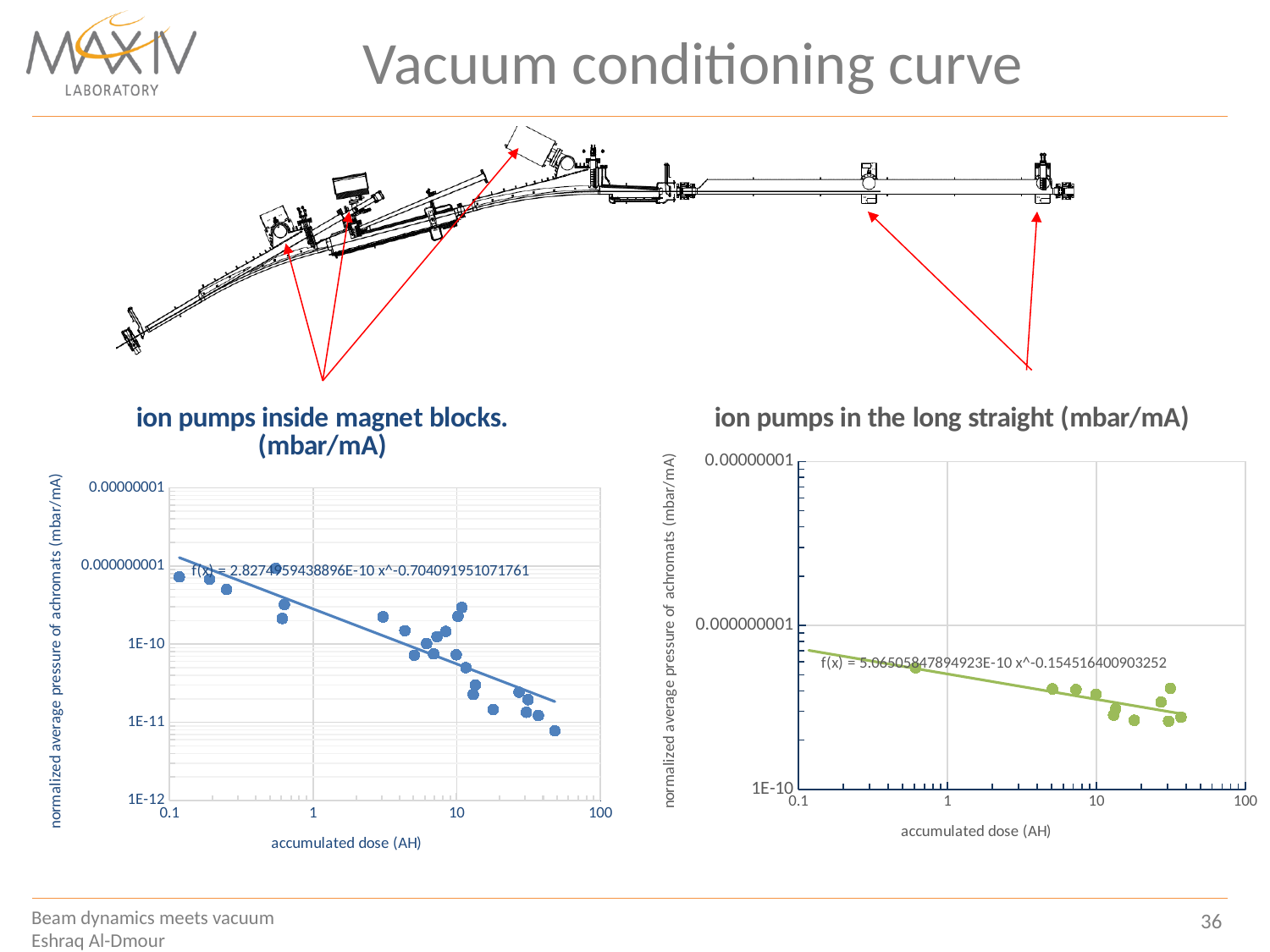
What kind of chart is the 'ion pumps in the long straight' chart? scatter chart What is the trendline equation shown on the 'ion pumps in the long straight' chart? f(x) = 5.06505847894923E-10 x^-0.154516400903252 In the 'ion pumps in the long straight' chart, do the plotted values rise or fall as accumulated dose increases? fall What is the lowest value shown on the y-axis of the 'ion pumps inside magnet blocks' chart? 1E-12 In the 'ion pumps inside magnet blocks' chart, is the value at an accumulated dose of about 0.1 AH greater or less than 0.000000001? less In the 'ion pumps inside magnet blocks' chart, do the plotted values rise or fall as accumulated dose increases? fall What is the x-axis title of the 'ion pumps inside magnet blocks' chart? accumulated dose (AH) In the 'ion pumps inside magnet blocks' chart, is the value at an accumulated dose of about 0.1 AH greater or less than the value at about 50 AH? greater What kind of chart is the 'ion pumps inside magnet blocks' chart? scatter chart In the 'ion pumps in the long straight' chart, is the value at an accumulated dose of about 30 AH greater or less than 1E-10? greater In the 'ion pumps inside magnet blocks' chart, is the value at an accumulated dose of about 0.6 AH greater or less than 1E-10? greater